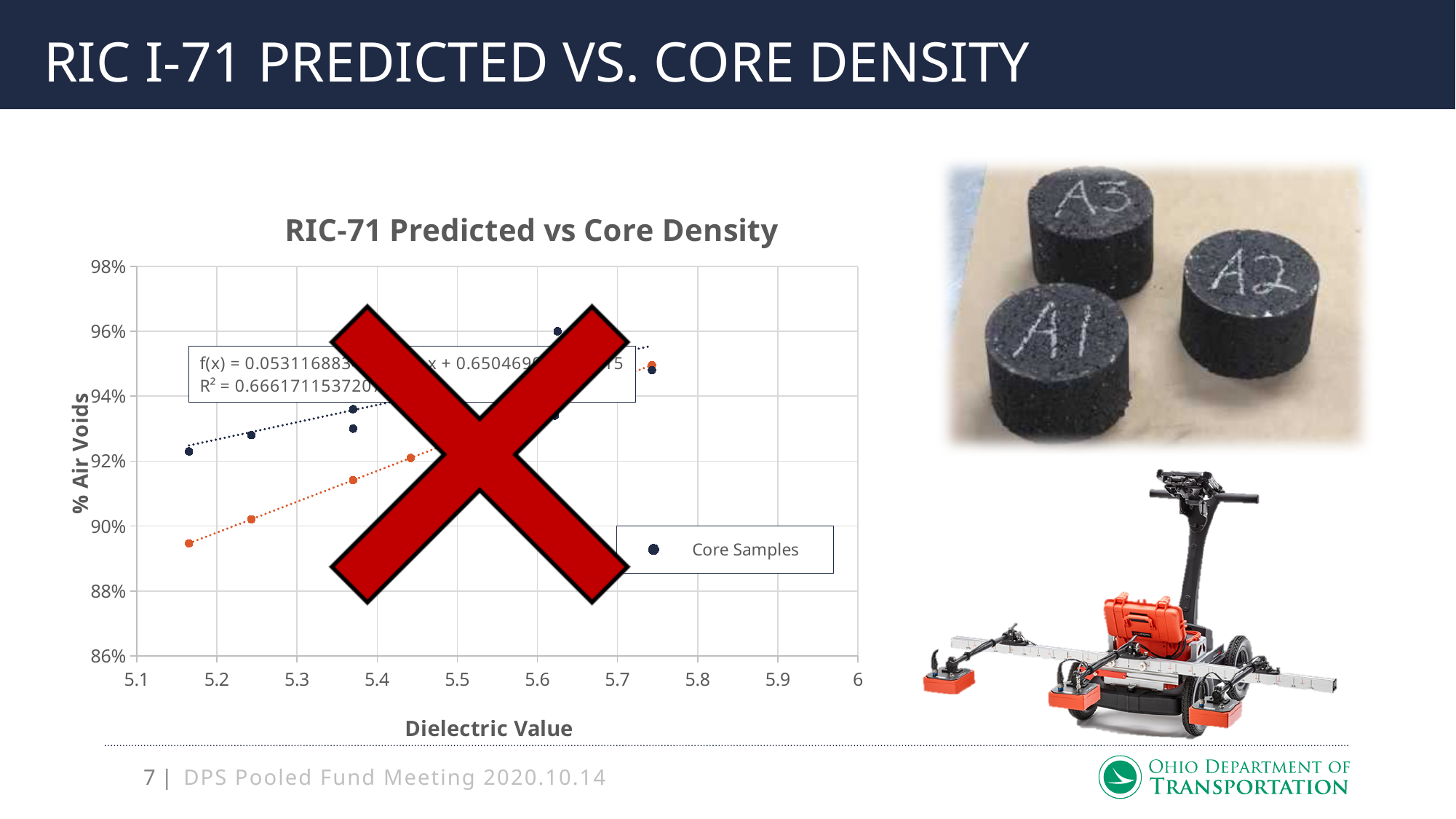
What is the label on the chart's x axis? Dielectric Value At the lowest dielectric value (about 5.16), which point has the higher % air voids, the dark blue point or the orange point? the dark blue point What kind of chart is shown on the slide? Scatter chart What is the title of the chart? RIC-71 Predicted vs Core Density Is the value of the dark blue Core Samples point at the lowest dielectric value (about 5.16) greater or less than 90%? greater Is the value of the orange point at the lowest dielectric value (about 5.16) greater or less than 90%? less How many series does the chart's legend list? 1 Do the orange points generally rise or fall as the dielectric value increases? rise Do the dark blue Core Samples points generally rise or fall as the dielectric value increases? rise Is the value of the orange point near a dielectric value of 5.37 greater or less than 92%? less